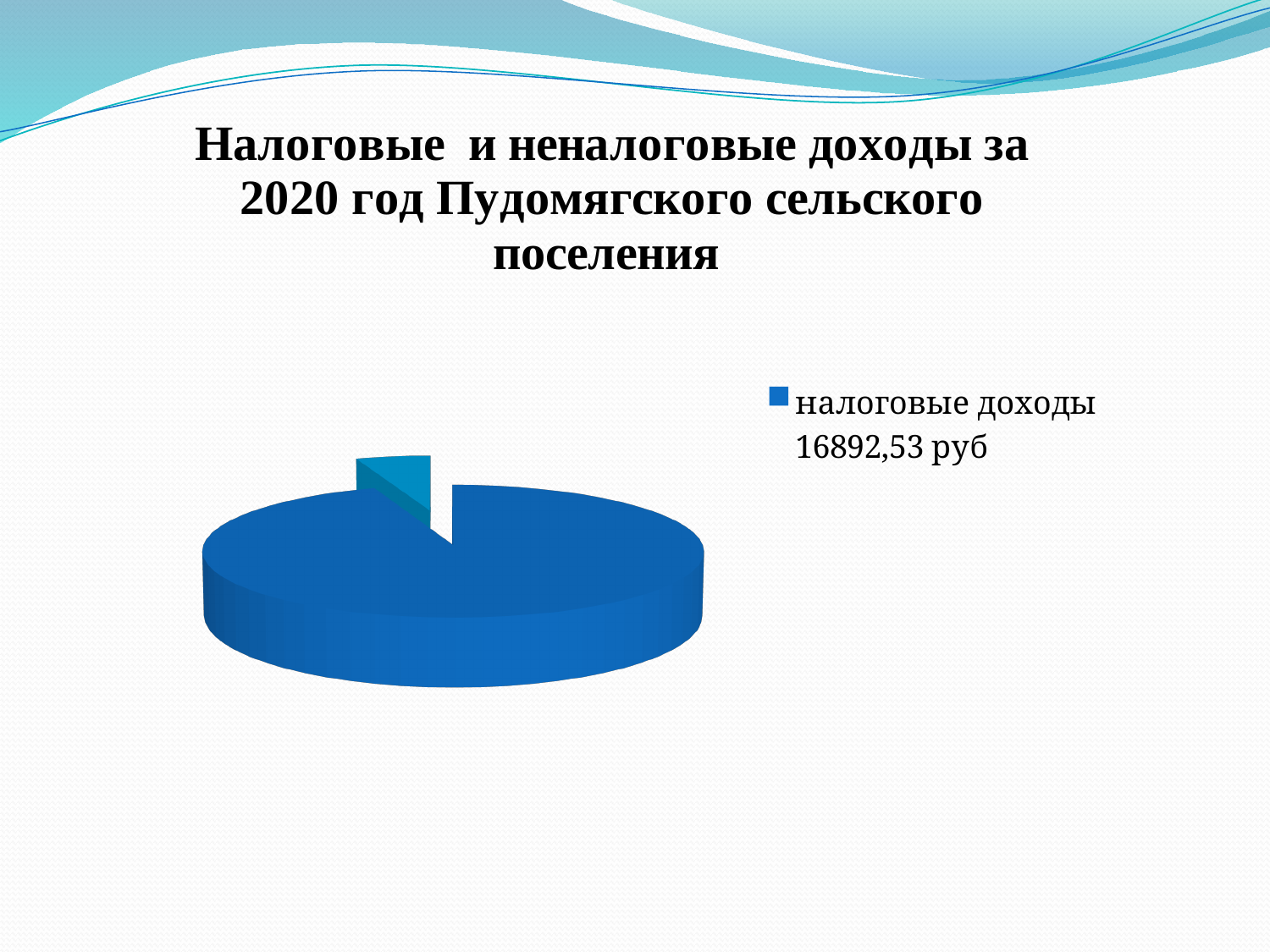
How many slices does the pie chart have? 2 What colour is the legend marker for налоговые доходы? blue How many entries does the chart legend list? 1 What kind of chart is shown on the slide? pie chart What value is printed in the legend for налоговые доходы? 16892,53 руб What is the title of the slide containing the chart? Налоговые и неналоговые доходы за 2020 год Пудомягского сельского поселения Which slice of the pie is larger: the one for налоговые доходы or the small unlabeled slice? налоговые доходы Which category takes up the largest share of the pie? налоговые доходы